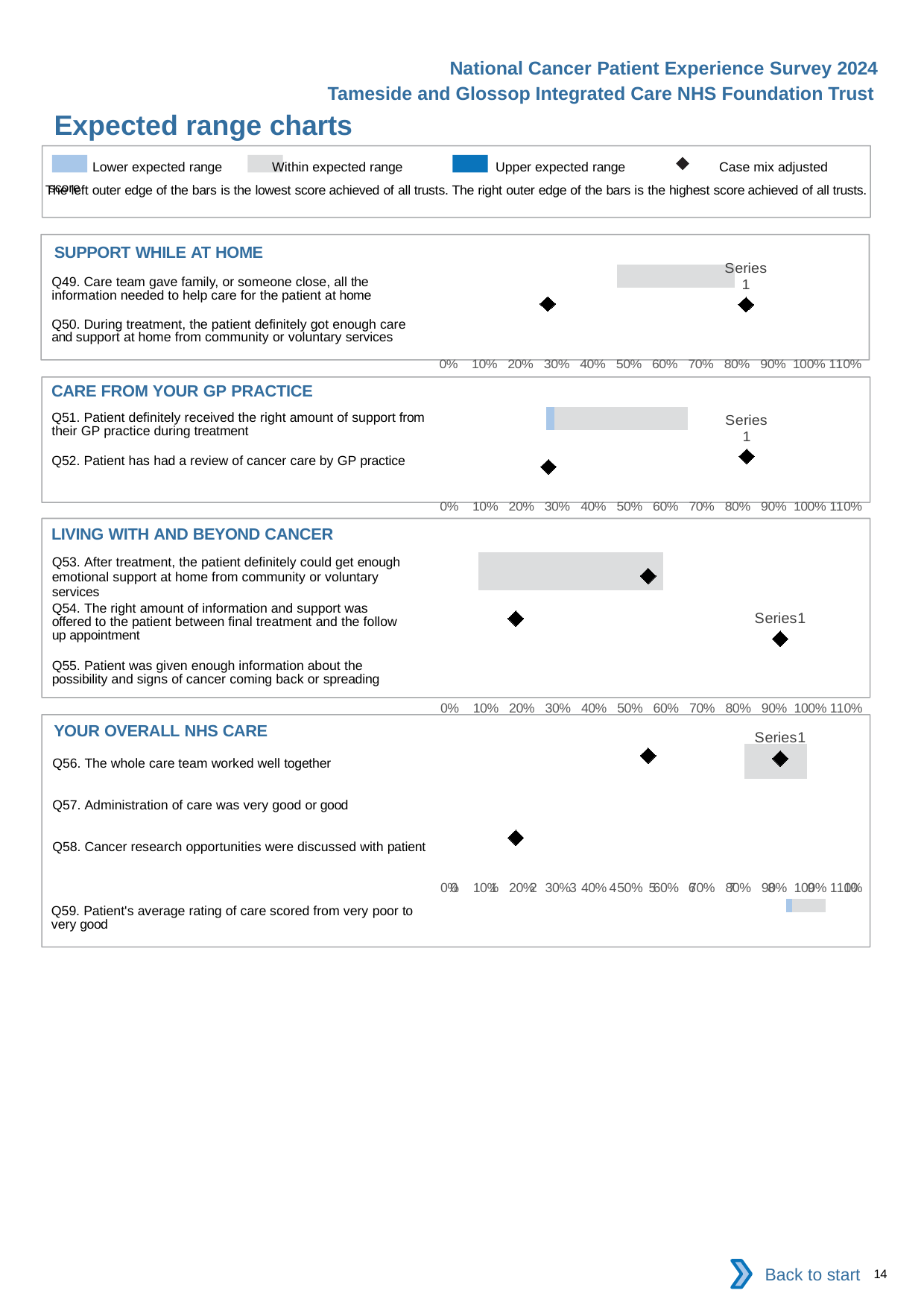
In the CARE FROM YOUR GP PRACTICE chart, is the leftmost diamond marker greater or less than 50%? less How many entries does the legend at the top of the slide list? 4 In the LIVING WITH AND BEYOND CANCER chart, is the leftmost diamond marker greater or less than 30%? less How many chart sections are shown on the slide? 4 What kind of chart is used in the SUPPORT WHILE AT HOME section? bar chart In the YOUR OVERALL NHS CARE chart, is the rightmost diamond marker greater or less than 80%? greater How many questions are listed in the LIVING WITH AND BEYOND CANCER chart? 3 How many questions are listed in the YOUR OVERALL NHS CARE chart? 4 What is the highest value shown on the x axis of the SUPPORT WHILE AT HOME chart? 110% Which legend entry is shown with a dark blue bar? Upper expected range